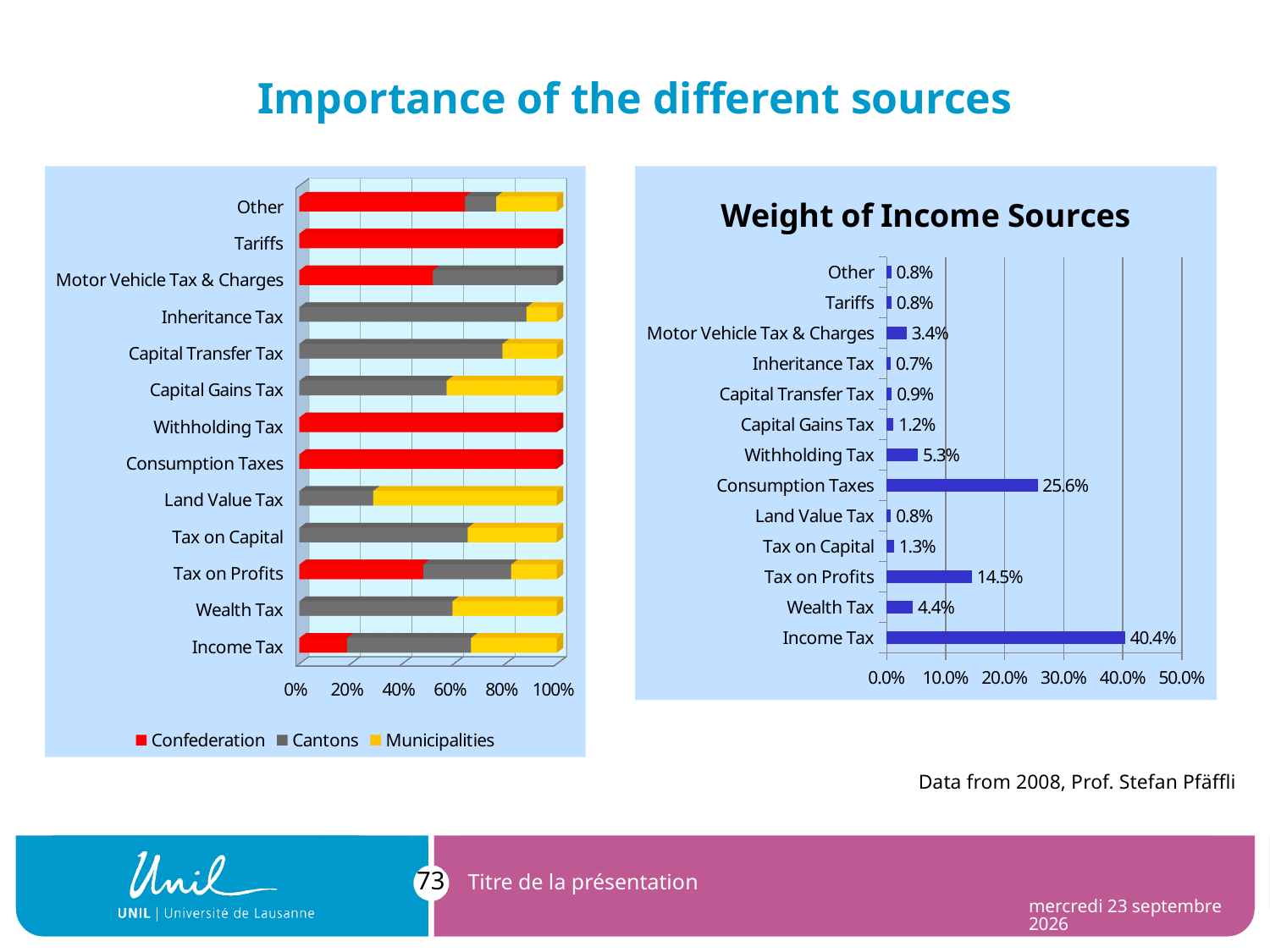
In the 'Weight of Income Sources' chart, which category has the lowest value? Inheritance Tax How many categories are shown in the 'Weight of Income Sources' chart? 13 How many series does the legend of the left-hand stacked bar chart list? 3 In the 'Weight of Income Sources' chart, what is the value for Income Tax? 40.4% In the left-hand stacked bar chart, which series is shown in red? Confederation In the 'Weight of Income Sources' chart, what is the difference between Income Tax and Consumption Taxes? 14.8% In the 'Weight of Income Sources' chart, which is larger: Tax on Profits or Wealth Tax? Tax on Profits In the left-hand stacked bar chart, is the Cantons share for Land Value Tax greater or less than 20%? greater In the 'Weight of Income Sources' chart, what is the value for Consumption Taxes? 25.6% In the 'Weight of Income Sources' chart, which category has the highest value? Income Tax In the 'Weight of Income Sources' chart, what is the value for Withholding Tax? 5.3% What type of chart is the left-hand chart on the slide? Stacked bar chart